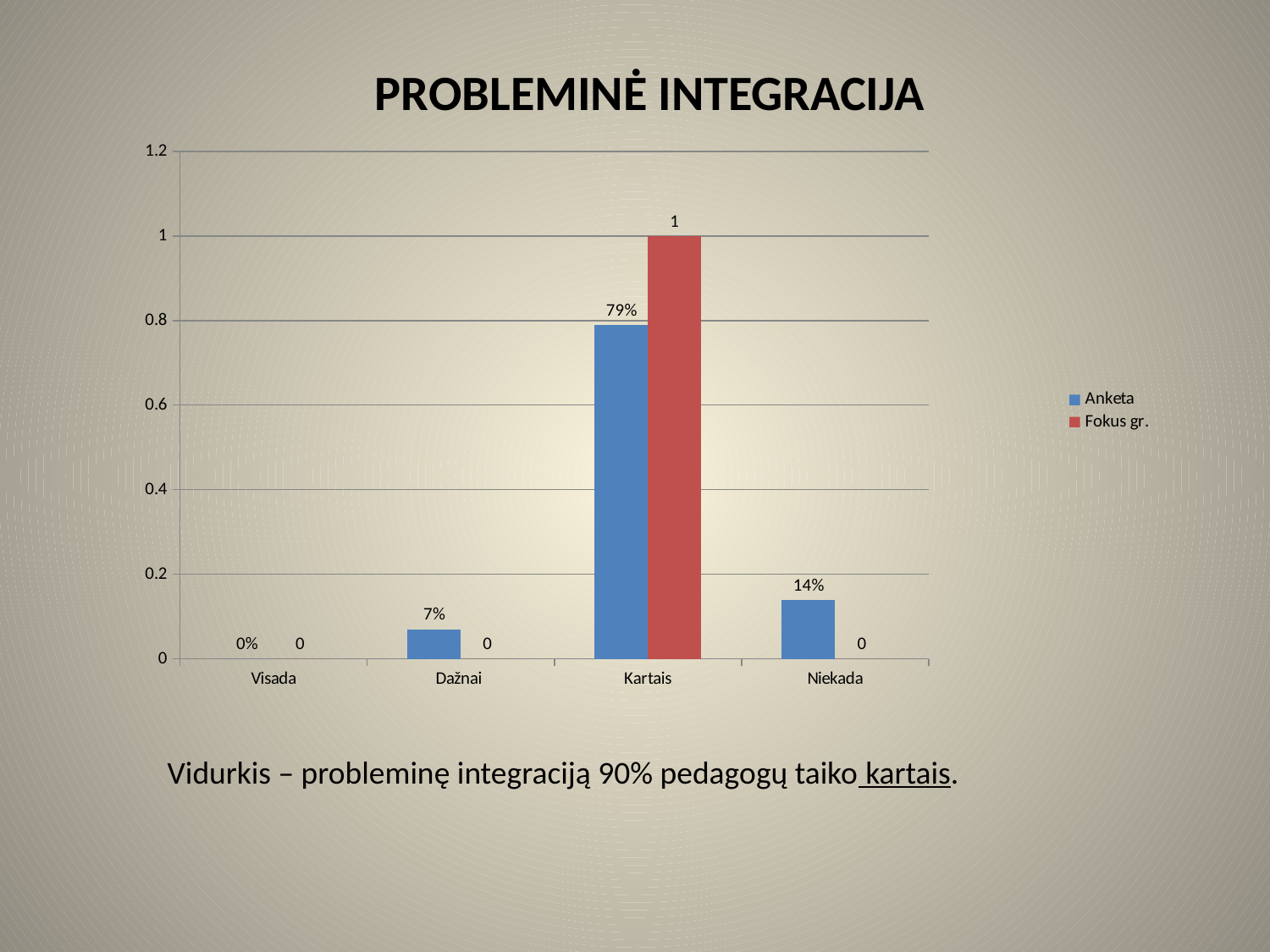
Which is larger in the Kartais category, the Anketa value or the Fokus gr. value? Fokus gr. What is the value for Anketa in the Dažnai category? 7% What is the value for Fokus gr. in the Kartais category? 1 What is the value for Fokus gr. in the Niekada category? 0 What kind of chart is shown on the slide? Bar chart Which category has the lowest Anketa value? Visada How many series does the legend list? 2 How many categories are shown on the x axis? 4 What is the value for Anketa in the Niekada category? 14% What is the value for Anketa in the Kartais category? 79% What is the difference between the Anketa values for Niekada and Dažnai? 7% Which category has the highest Anketa value? Kartais